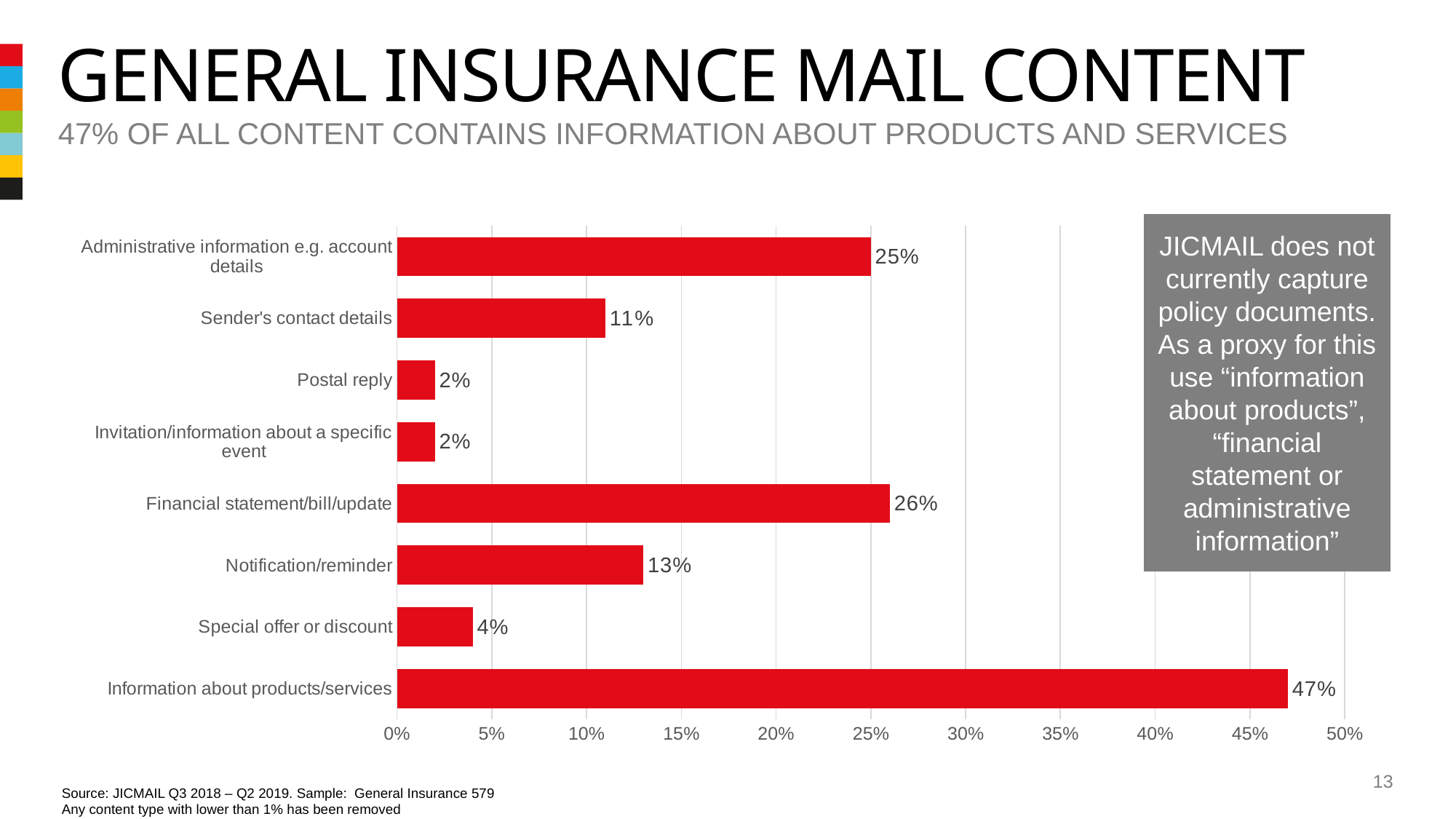
Is the value for Administrative information e.g. account details greater or less than 20%? greater What kind of chart is shown on the slide? Bar chart What is the difference between Financial statement/bill/update and Administrative information e.g. account details? 1% What is the value for Sender's contact details? 11% What is the difference between Information about products/services and Special offer or discount? 43% Which is larger, Notification/reminder or Sender's contact details? Notification/reminder Which content type has the highest value? Information about products/services How many content types are shown in the chart? 8 What percentage of general insurance mail content is information about products/services? 47% What is the value for Notification/reminder? 13% What is the value for Financial statement/bill/update? 26% What colour are the bars in the chart? Red